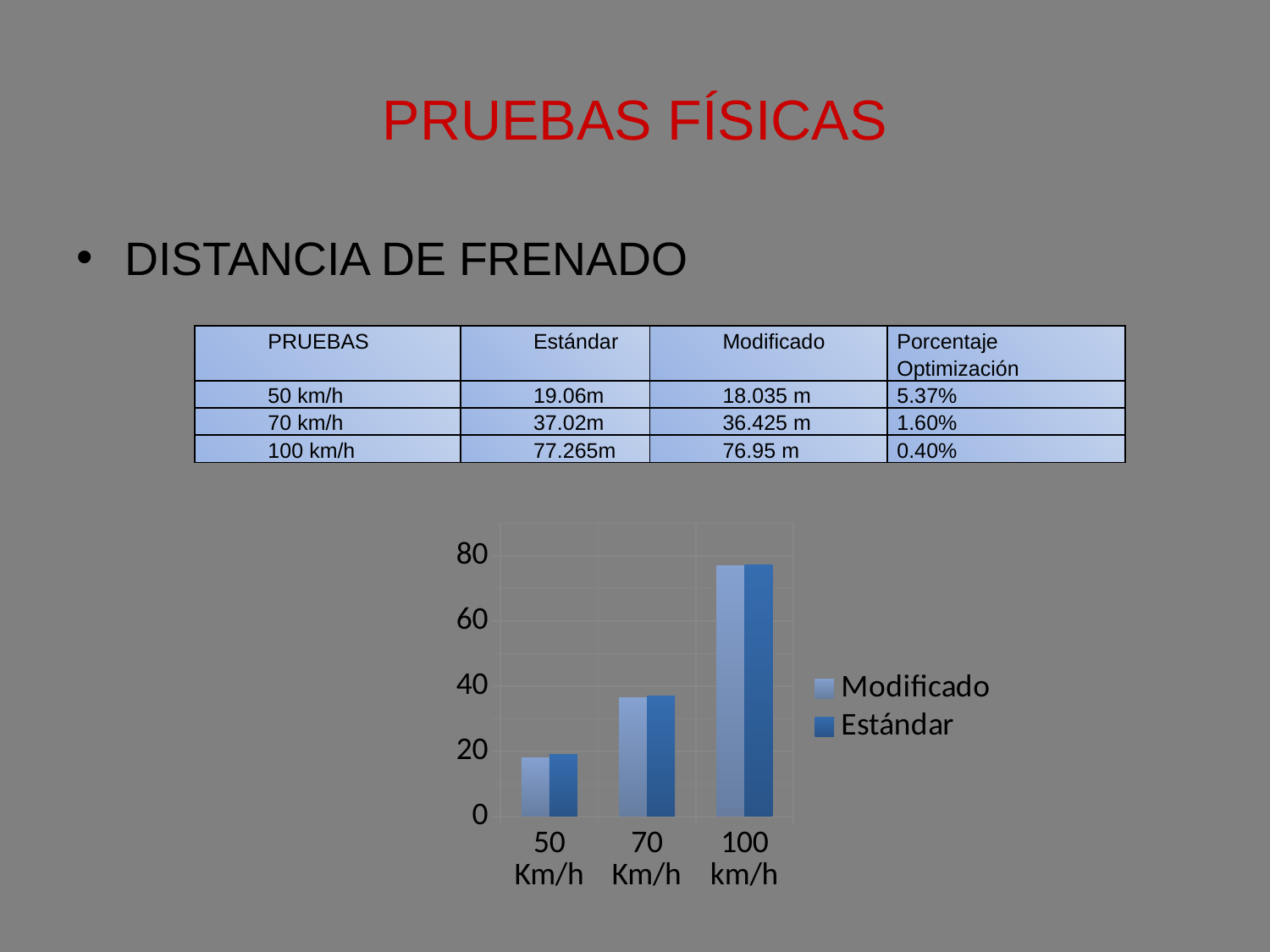
Which category has the highest Modificado bar in the chart? 100 km/h Do the Modificado values rise or fall as speed increases along the x axis? rise What are the two series names listed in the chart legend? Modificado and Estándar How many series does the chart legend list? 2 Is the Modificado value for 100 km/h greater or less than 60? greater Is the Estándar value for 100 km/h greater or less than 80? less Which is larger in the chart: the Estándar bar for 70 Km/h or the Estándar bar for 100 km/h? 100 km/h How many categories are shown on the x axis of the chart? 3 What kind of chart is shown on the slide? bar chart Is the Estándar value for 70 Km/h greater or less than 40? less Which category has the lowest Estándar bar in the chart? 50 Km/h